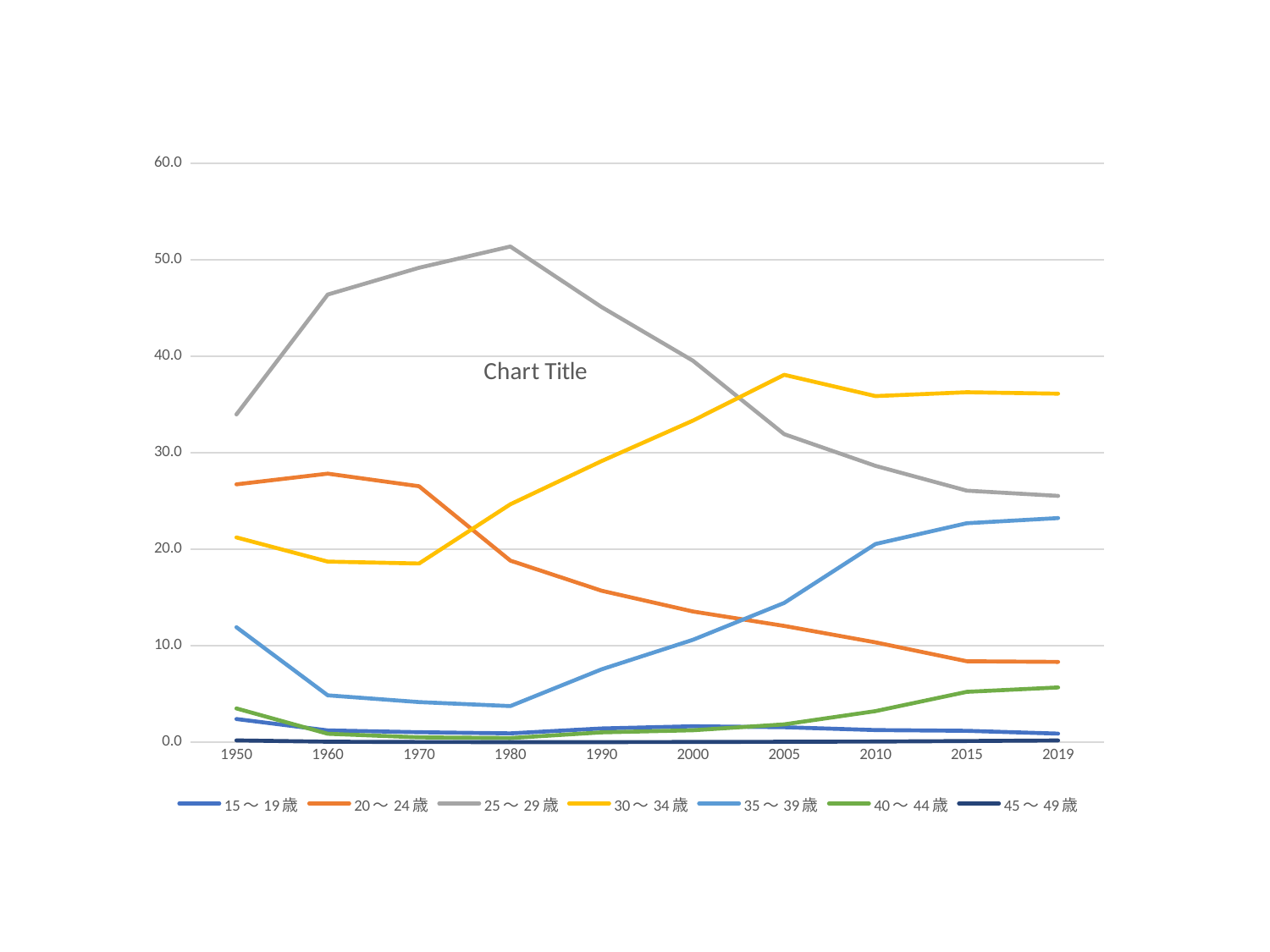
What kind of chart is shown on the slide? line chart Is the value for 25～29歳 in 1960 greater or less than 40? greater Is the value for 30～34歳 in 2005 greater or less than 30? greater Which series has the lowest value in 1950? 45～49歳 Which series has the highest value in 2019? 30～34歳 How many series does the legend list? 7 Does the 20～24歳 line rise or fall from 1980 to 2019? fall Which series has the highest value in 1980? 25～29歳 Is the value for 20～24歳 in 2019 greater or less than 10? less How many years are shown along the x axis? 10 In 1950, which is larger: the value for 20～24歳 or the value for 30～34歳? 20～24歳